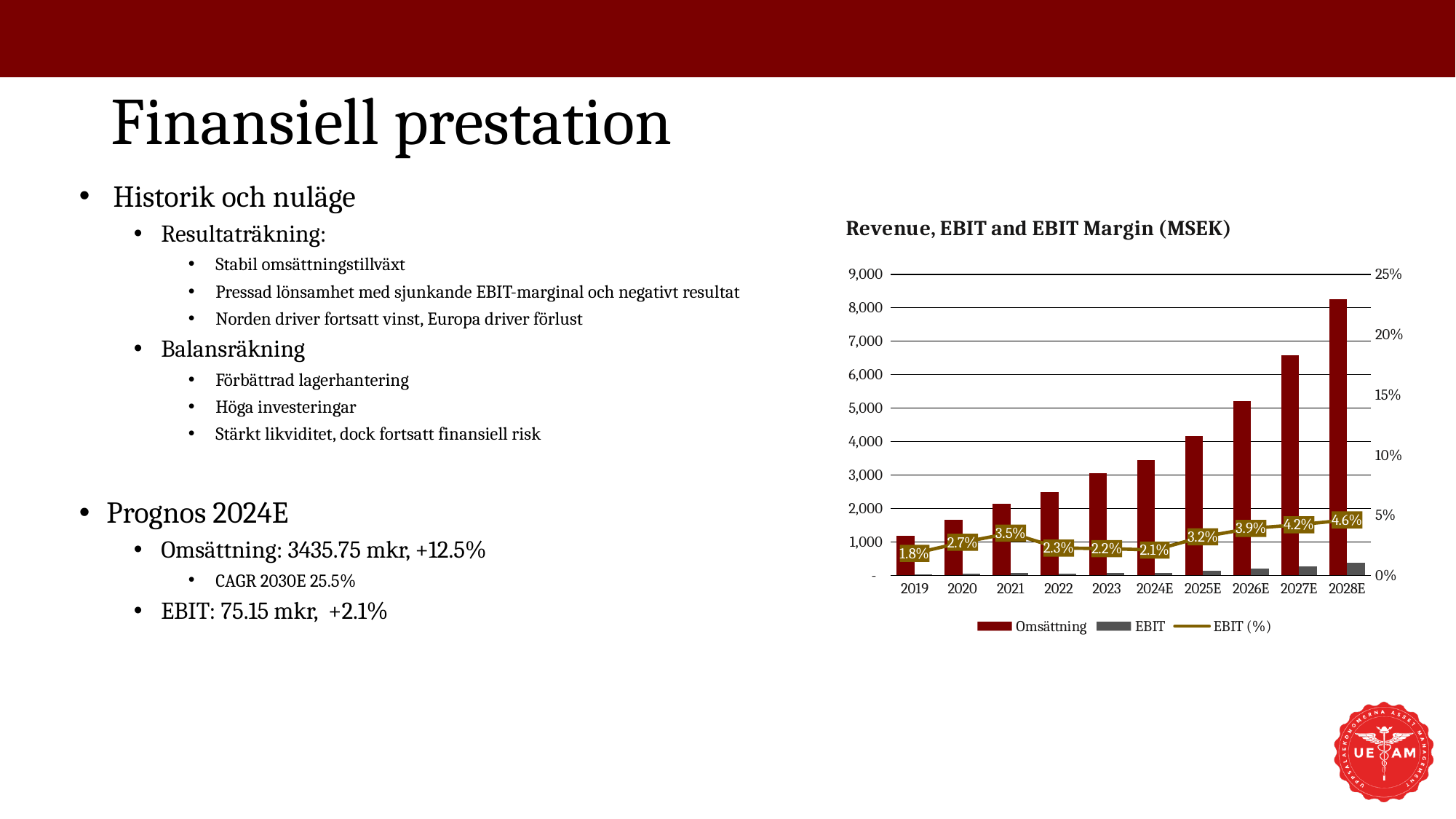
How many years are shown on the x axis of the chart? 10 Is the Omsättning value for 2022 greater or less than 3,000? less What is the EBIT (%) value for 2019? 1.8% By how many percentage points does the EBIT (%) for 2028E exceed that for 2019? 2.8 percentage points Which year has the higher EBIT (%), 2021 or 2022? 2021 What is the EBIT (%) value for 2024E? 2.1% Which year has the highest EBIT (%) value? 2028E What is the EBIT (%) value for 2028E? 4.6% Is the Omsättning value for 2028E greater or less than 8,000? greater Which year has the lowest EBIT (%) value? 2019 What is the title of the chart? Revenue, EBIT and EBIT Margin (MSEK) How many series does the chart legend list? 3